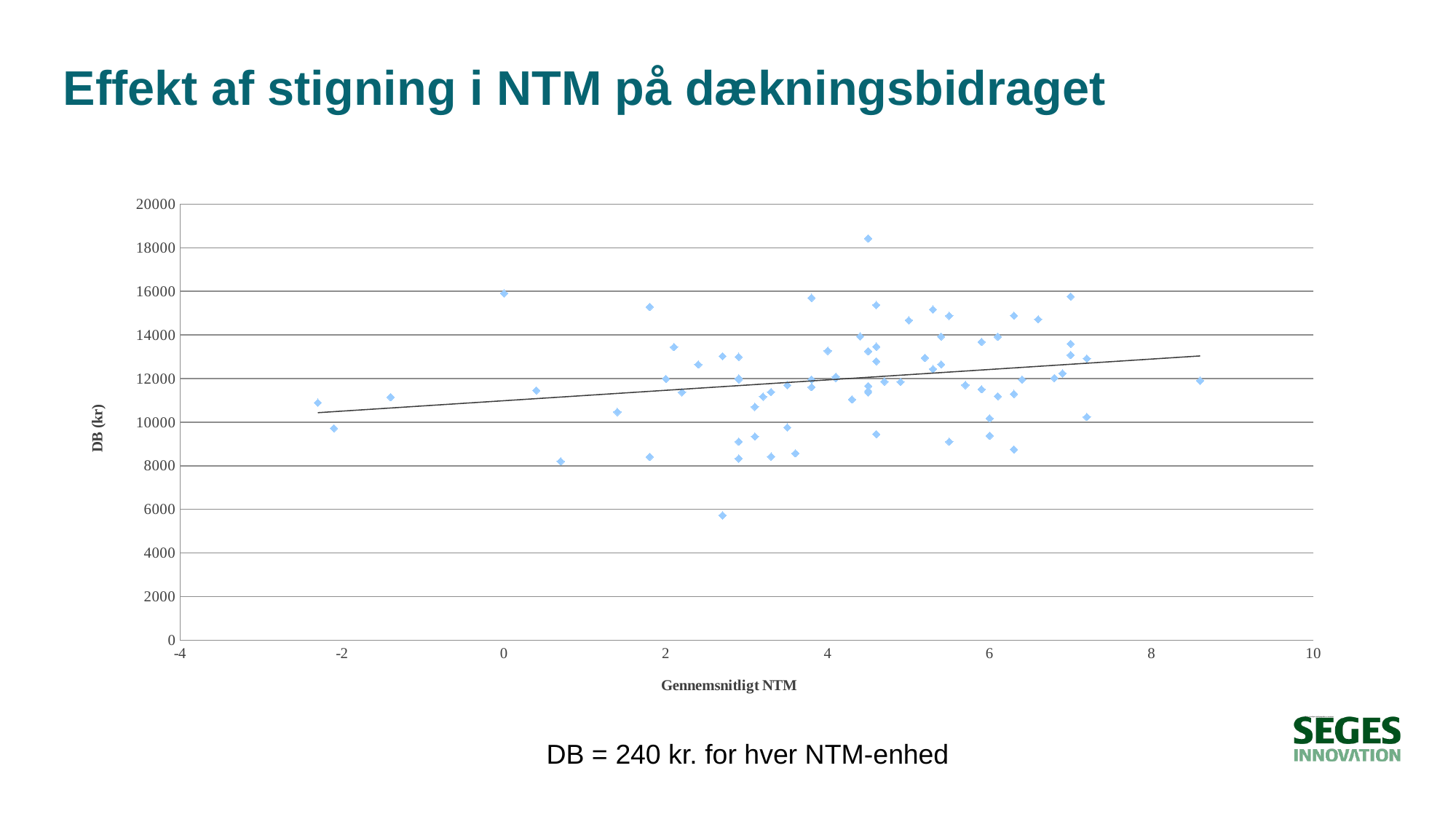
Is the DB value of the point at Gennemsnitligt NTM 0 greater or less than 14000? greater Is the DB value of the point with the highest Gennemsnitligt NTM (around 8.6) greater or less than 14000? less What kind of chart is shown on the slide? scatter chart What is the title of the y axis of the chart? DB (kr) Is the DB value of the lowest point in the chart greater or less than 6000? less Does the trend line in the chart rise or fall as Gennemsnitligt NTM increases? rise What is the highest value shown on the y axis of the chart? 20000 What is the title of the x axis of the chart? Gennemsnitligt NTM